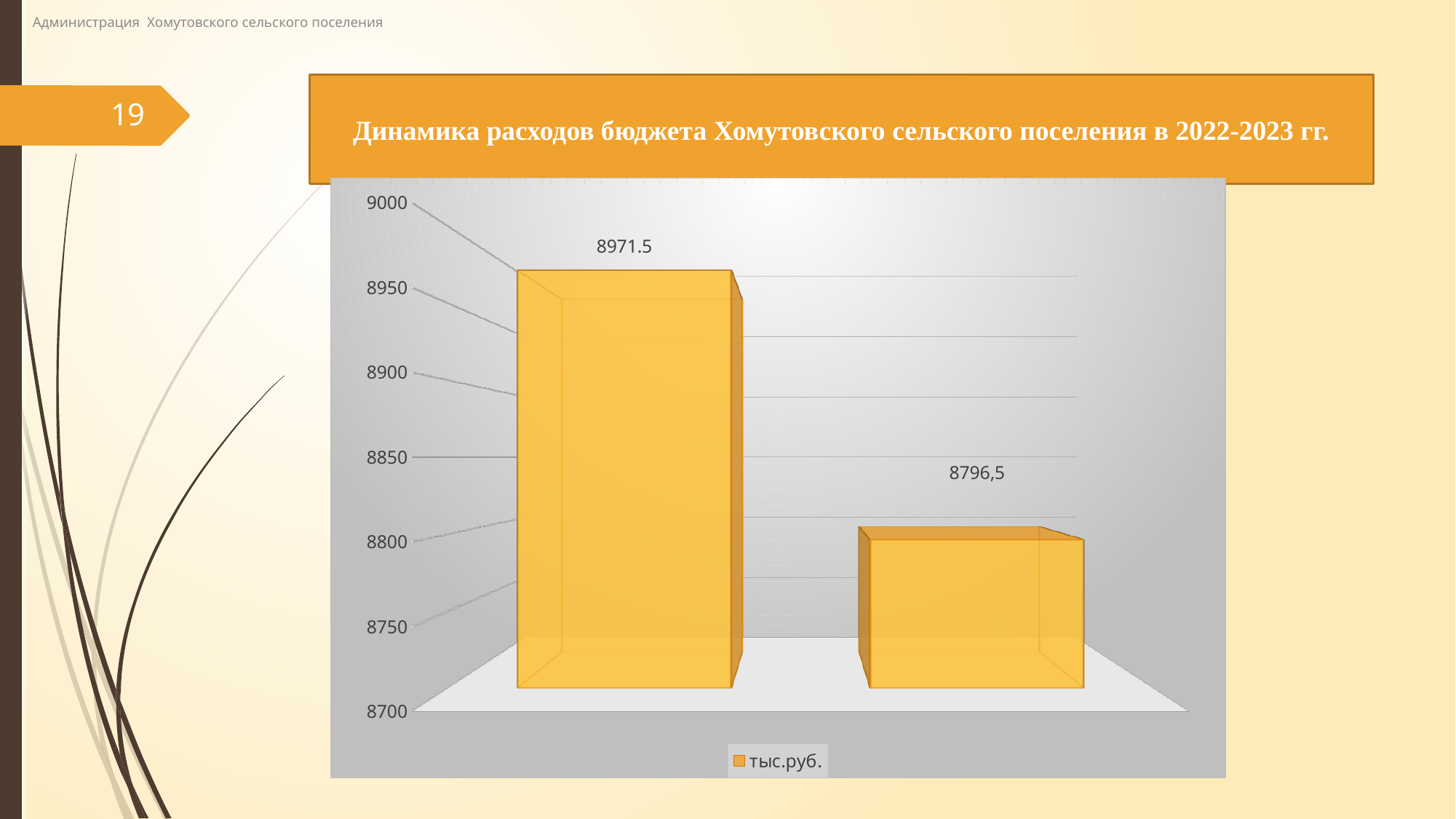
How many series does the legend list? 1 What is the difference between the left bar's value and the right bar's value? 175 What is the value shown on the data label of the right bar? 8796,5 Is the value of the left bar greater or less than 8950? greater Which bar is taller, the left one or the right one? the left one What kind of chart is shown on the slide? bar chart Is the value of the right bar greater or less than 8800? less What is the value of the shortest bar in the chart? 8796,5 What is the value of the tallest bar in the chart? 8971.5 How many bars are plotted in the chart? 2 What is the legend entry shown below the chart? тыс.руб. What is the value shown on the data label of the left bar? 8971.5